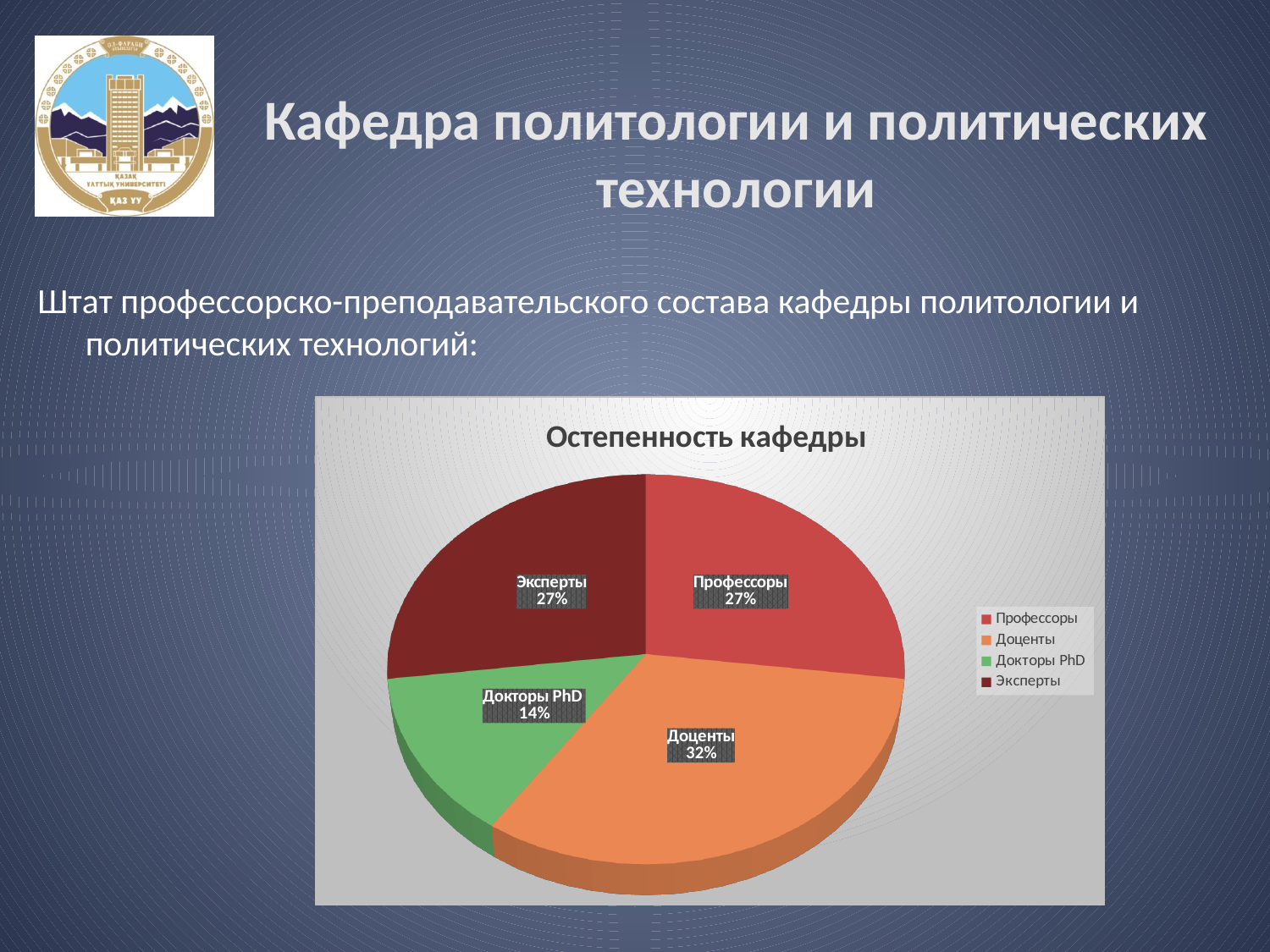
How many categories are shown in the pie chart? 4 What is the difference in percentage points between Доценты and Доктора PhD? 18 What is the title of the chart? Остепенность кафедры What colour is the Доктора PhD slice? green What share of the pie does Эксперты hold? 27% What share of the pie does Профессоры hold? 27% Which is larger, the share for Доценты or the share for Профессоры? Доценты What share of the pie does Доктора PhD hold? 14% What kind of chart is shown on the slide? pie chart Which category has the largest slice of the pie? Доценты Which category has the smallest slice of the pie? Докторы PhD